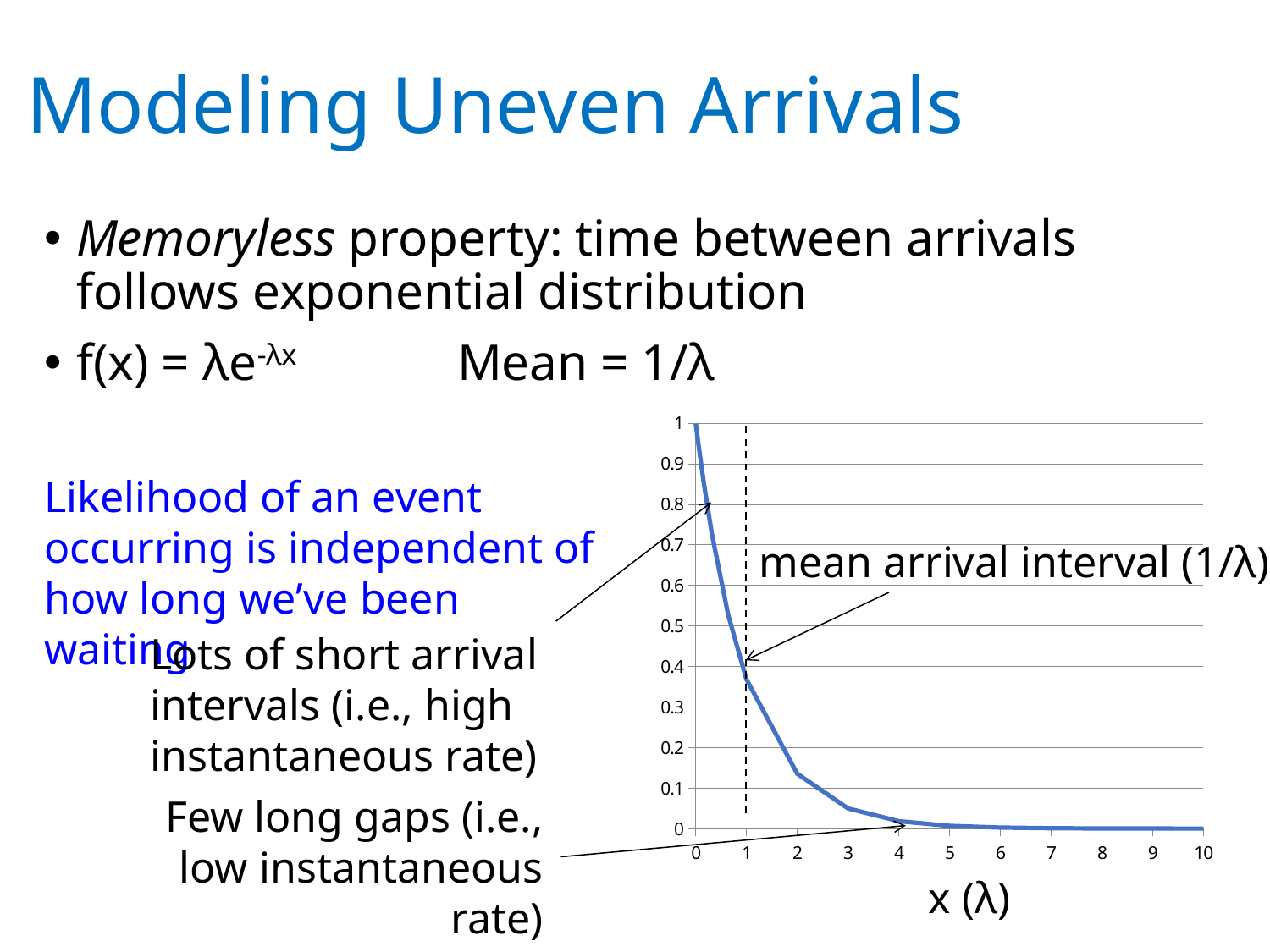
Is the plotted value at x = 1 greater or less than 0.5? less How many tick labels are shown on the x axis? 11 Is the plotted value at x = 1 greater or less than 0.3? greater Is the plotted value at x = 3 greater or less than 0.1? less Which is larger, the plotted value at x = 1 or at x = 4? x = 1 At which x value is the plotted curve highest? 0 What is the label on the x axis of the chart? x (λ) At which x value is the dashed vertical line labelled "mean arrival interval (1/λ)" drawn? 1 Do the plotted values rise or fall as x increases along the x axis? fall What kind of chart is shown on the slide? line chart